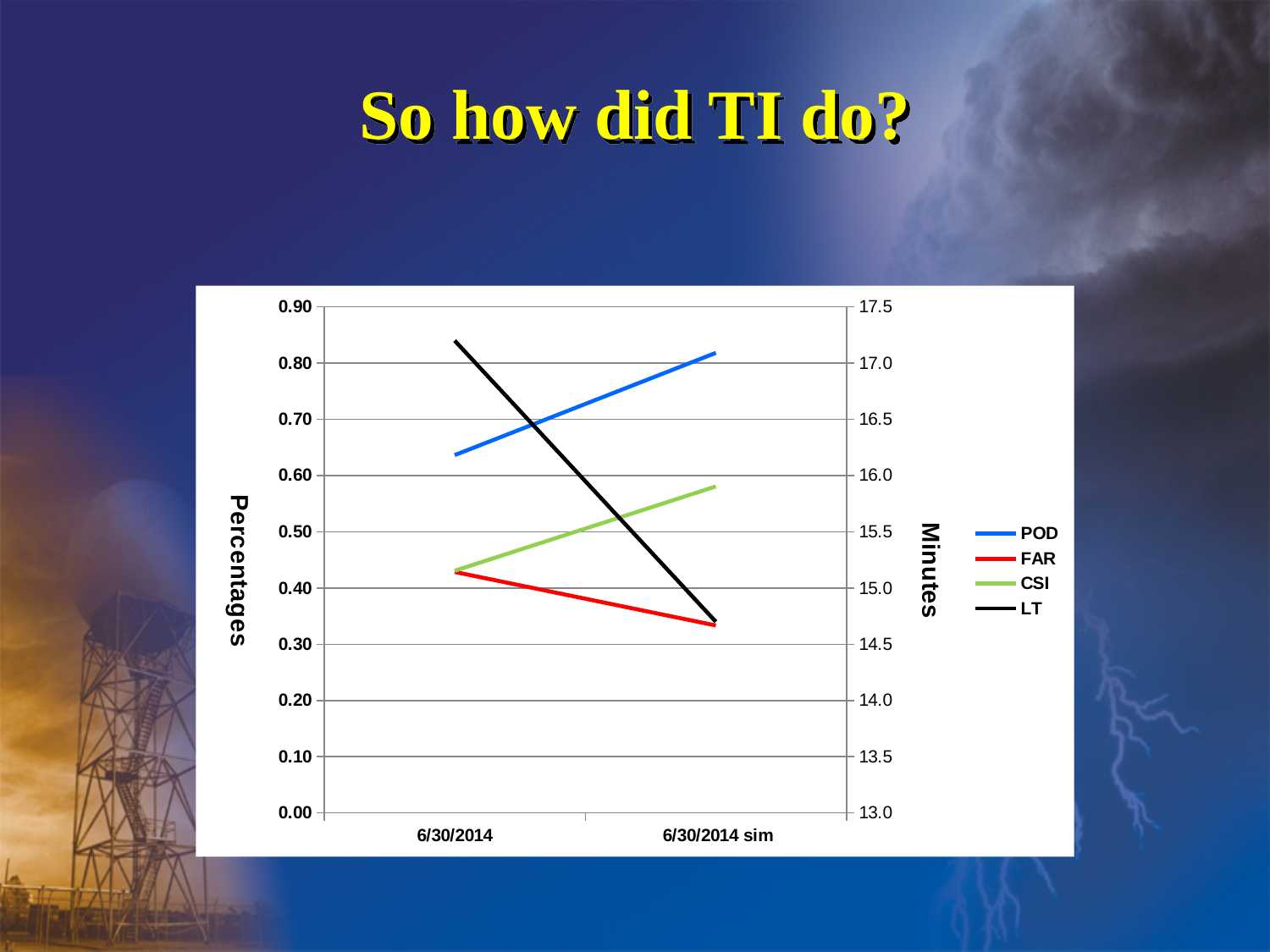
Is the CSI value for 6/30/2014 sim greater or less than 0.50? greater What kind of chart is shown on the slide? line chart Does the FAR line rise or fall from 6/30/2014 to 6/30/2014 sim? fall Does the LT line rise or fall from 6/30/2014 to 6/30/2014 sim? fall Does the POD line rise or fall from 6/30/2014 to 6/30/2014 sim? rise How many categories are shown on the x axis? 2 Is the LT value for 6/30/2014 sim greater or less than 15.0 minutes? less Is the POD value for 6/30/2014 greater or less than 0.60? greater What is the title of the right-hand vertical axis? Minutes At 6/30/2014 sim, which is larger, POD or CSI? POD How many series does the legend list? 4